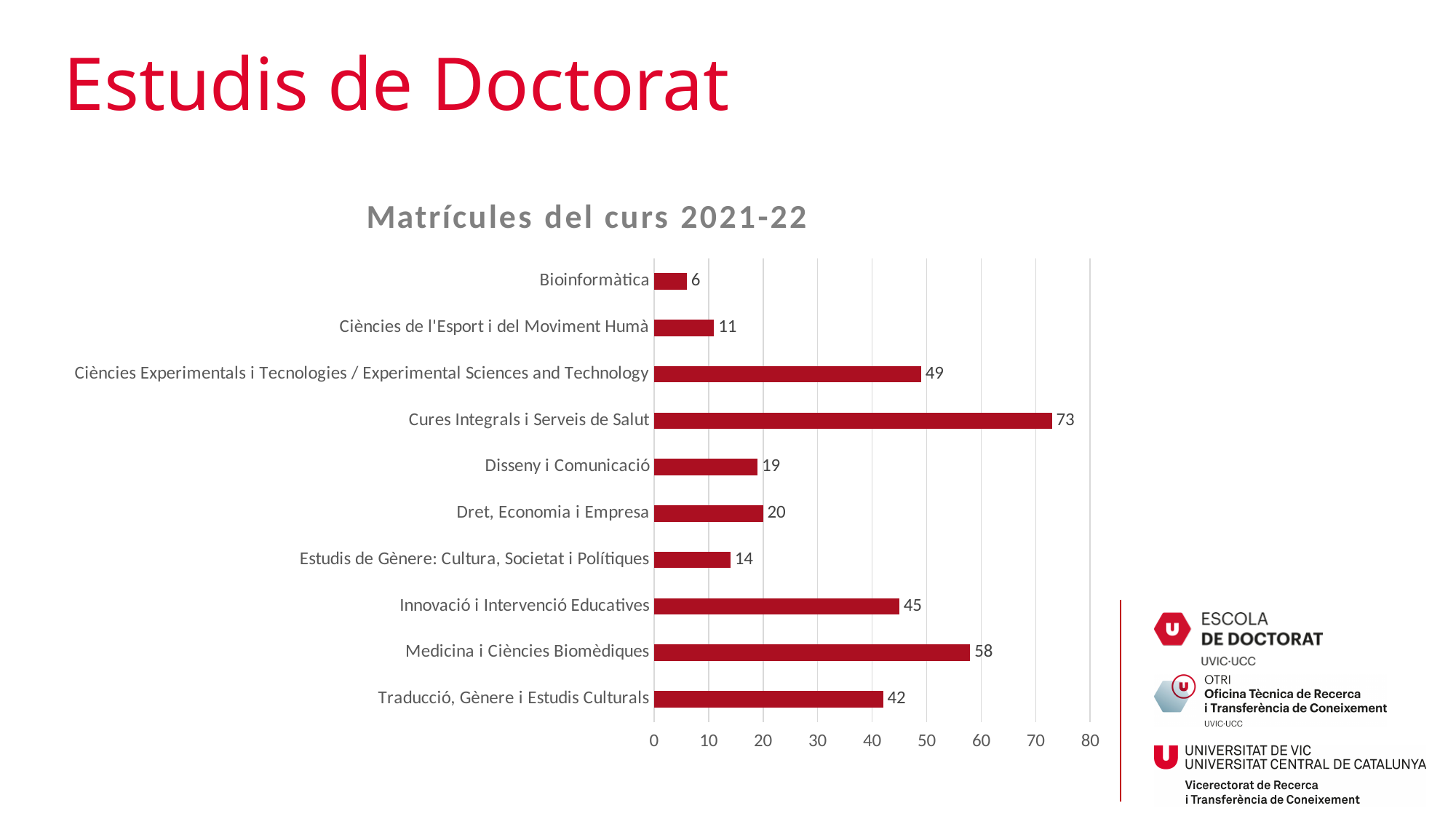
What is the value for Estudis de Gènere: Cultura, Societat i Polítiques? 14 What is the value for Bioinformàtica? 6 Which category has the lowest value? Bioinformàtica Which category has the highest value? Cures Integrals i Serveis de Salut Which is larger, the value for Ciències Experimentals i Tecnologies / Experimental Sciences and Technology or the value for Traducció, Gènere i Estudis Culturals? Ciències Experimentals i Tecnologies / Experimental Sciences and Technology How many categories are shown in the chart? 10 What is the title of the chart? Matrícules del curs 2021-22 What is the value for Cures Integrals i Serveis de Salut? 73 What is the difference between the values for Medicina i Ciències Biomèdiques and Innovació i Intervenció Educatives? 13 What is the value for Medicina i Ciències Biomèdiques? 58 What kind of chart is shown on the slide? bar chart Is the value for Dret, Economia i Empresa greater or less than 30? less